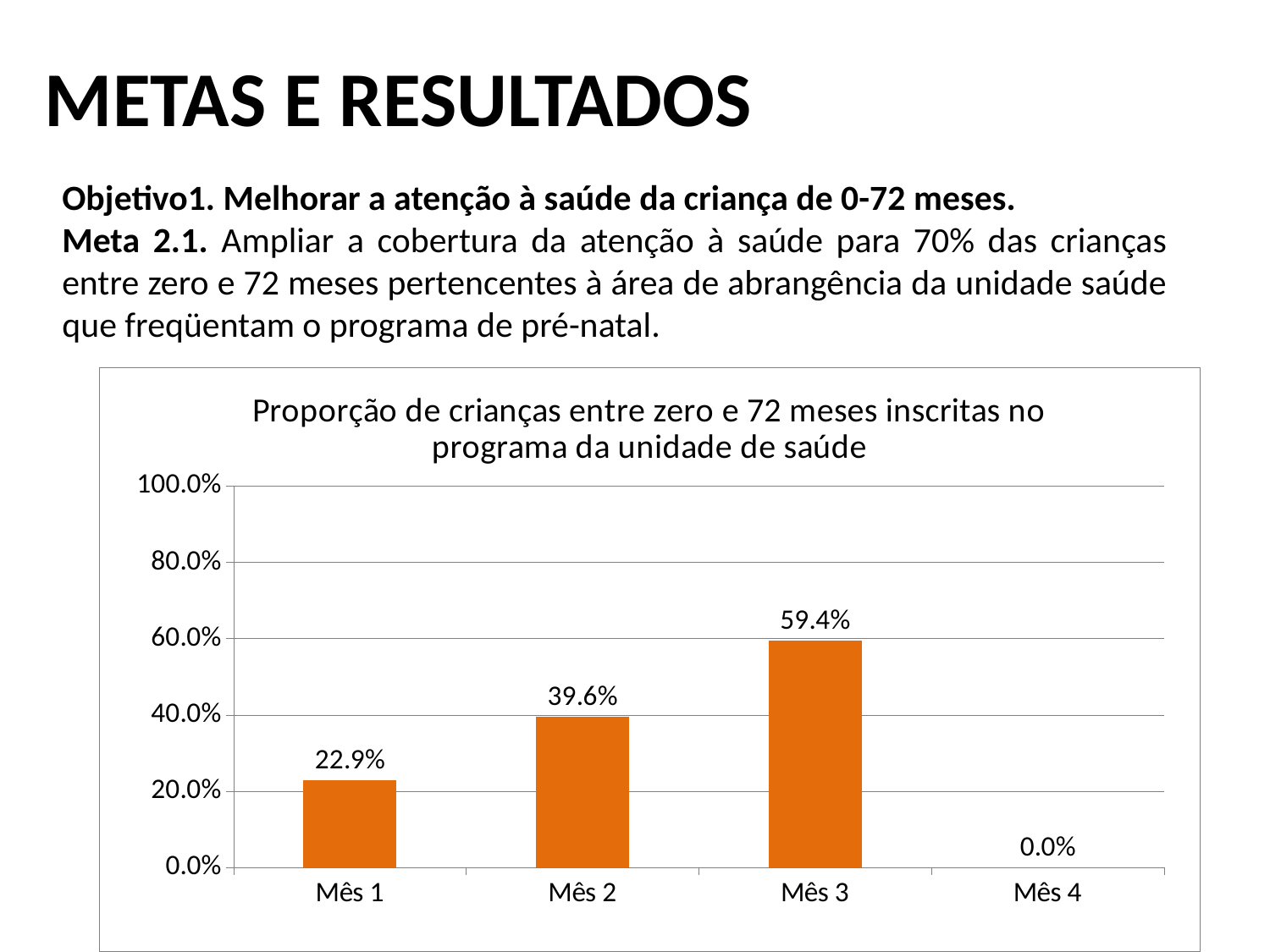
Is the value for Mês 3 greater or less than 40.0%? greater What is the value for Mês 2? 39.6% What is the value for Mês 1? 22.9% Which is larger, the value for Mês 1 or the value for Mês 2? Mês 2 What is the value for Mês 3? 59.4% What is the value for Mês 4? 0.0% Which month has the lowest value? Mês 4 Which month has the highest value? Mês 3 What is the difference between the values for Mês 2 and Mês 1? 16.7% What kind of chart is shown on the slide? bar chart How many months are shown on the x axis? 4 What is the difference between the values for Mês 3 and Mês 2? 19.8%